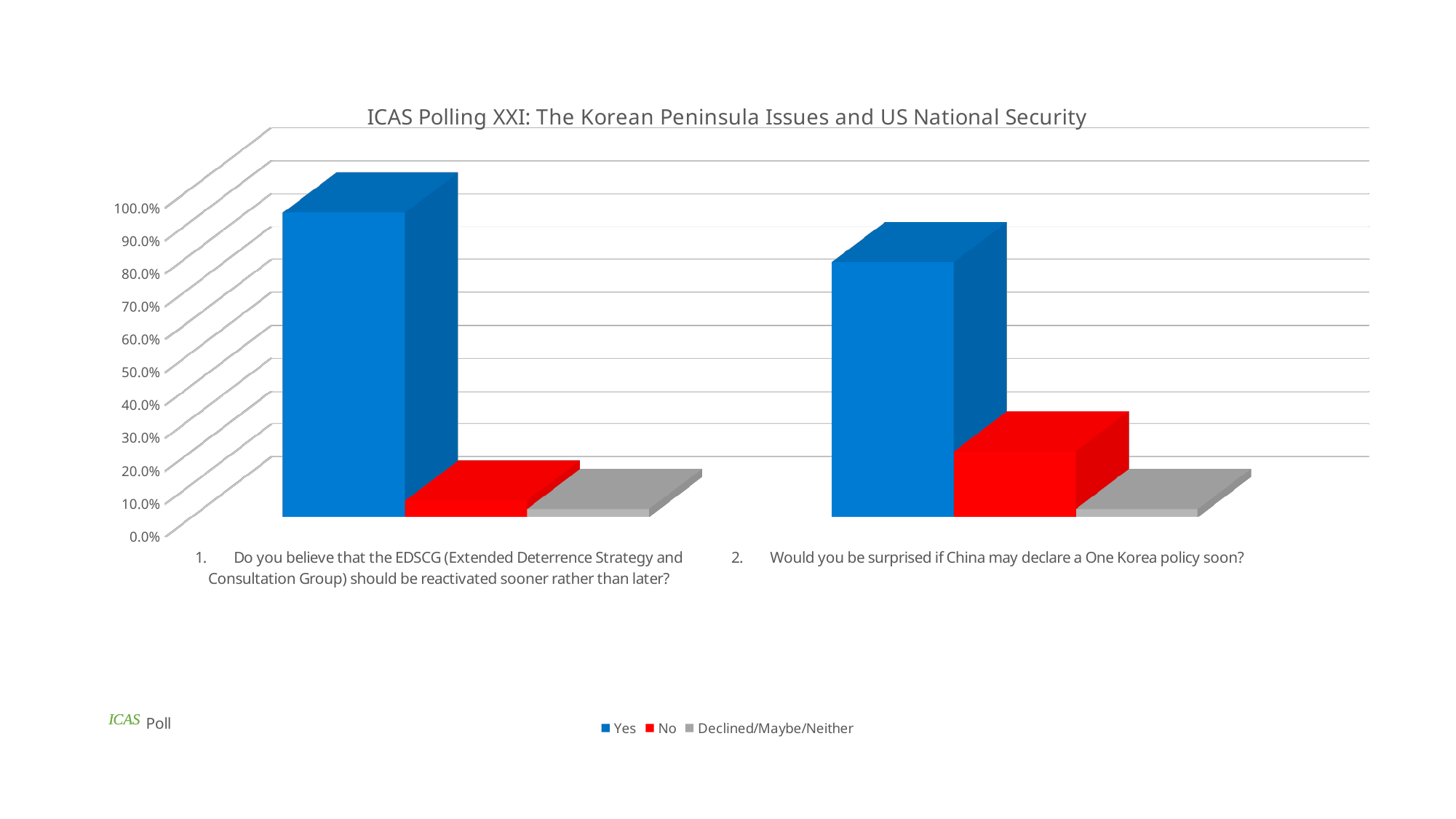
For question 2 (China One Korea policy), which response has the lowest value? Declined/Maybe/Neither What is the title of the chart? ICAS Polling XXI: The Korean Peninsula Issues and US National Security For question 1 (EDSCG reactivation), which response has the highest value? Yes What kind of chart is shown on the slide? Bar chart Is the "Yes" value for question 2 greater or less than 90.0%? less How many poll questions (categories) are plotted on the x axis? 2 How many series does the legend list? 3 Which colour represents the "No" series in the legend? Red Is the "No" value for question 2 greater or less than 30.0%? less Is the "No" value for question 1 greater or less than 10.0%? less Which question has the larger "No" value, question 1 or question 2? Question 2